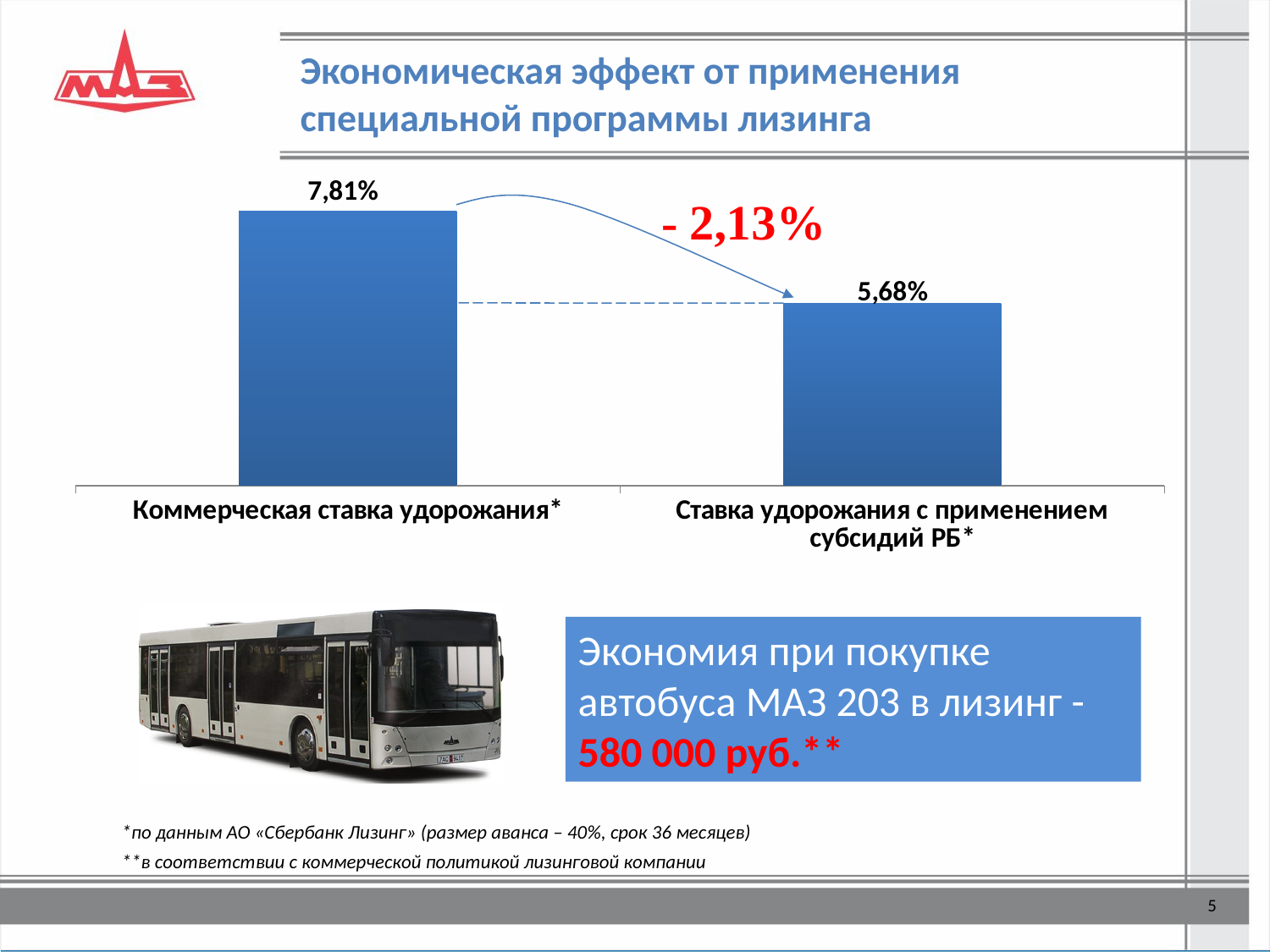
What colour are the bars in the chart? Blue Do the values rise or fall from left to right across the chart? Fall What is the difference between Коммерческая ставка удорожания* and Ставка удорожания с применением субсидий РБ*? 2,13% How many bars are shown in the chart? 2 Which is larger: Коммерческая ставка удорожания* or Ставка удорожания с применением субсидий РБ*? Коммерческая ставка удорожания* What kind of chart is shown on the slide? Bar chart What is the value for Коммерческая ставка удорожания*? 7,81% Which category has the highest value? Коммерческая ставка удорожания* Which category has the lowest value? Ставка удорожания с применением субсидий РБ* What is the value for Ставка удорожания с применением субсидий РБ*? 5,68% What change is annotated in red between the two bars? - 2,13%